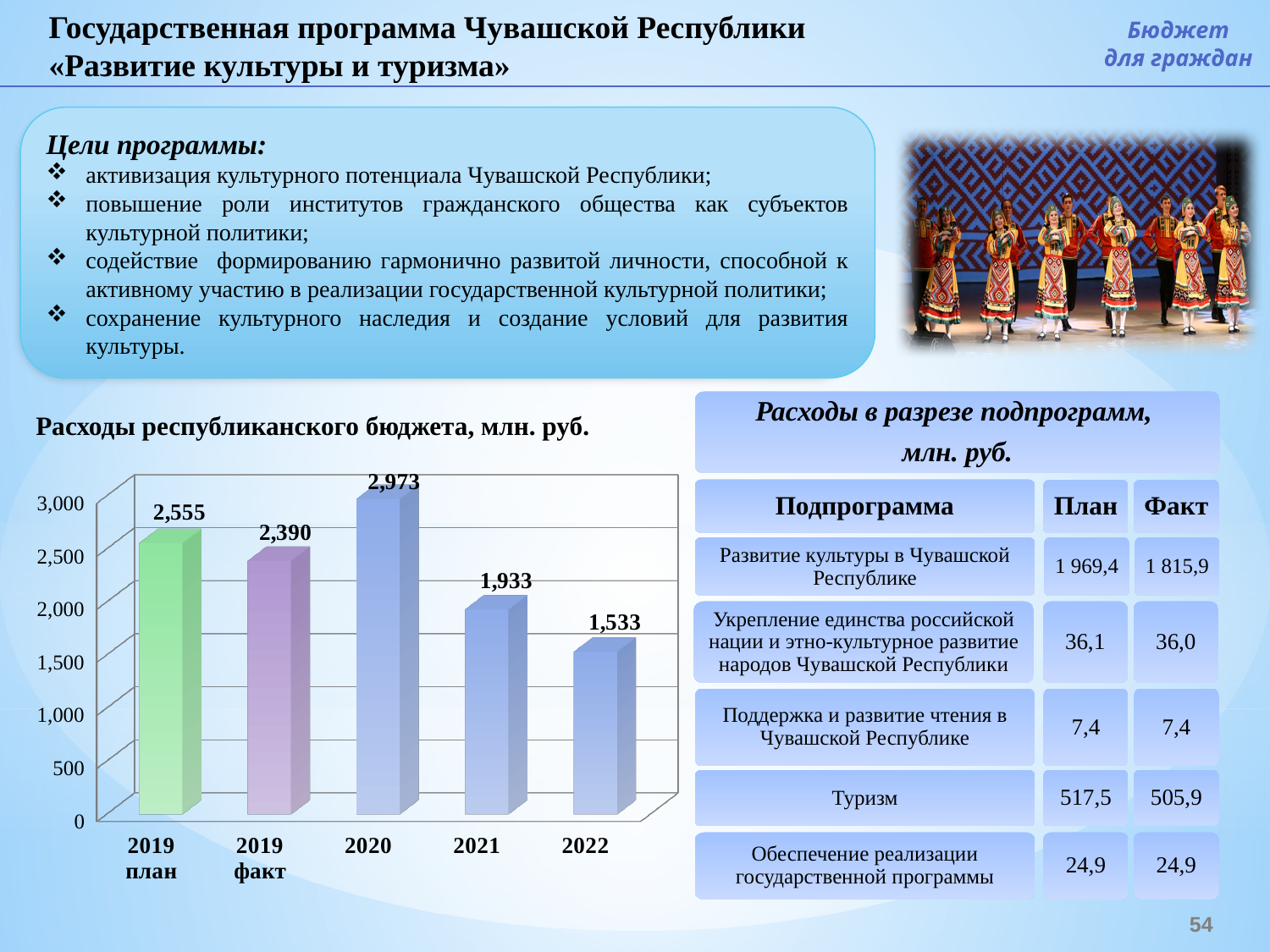
What is the difference between the 2020 and 2021 values in the chart 'Расходы республиканского бюджета, млн. руб.'? 1,040 Which is larger in the chart 'Расходы республиканского бюджета, млн. руб.': the value for 2021 or the value for 2022? 2021 What type of chart is 'Расходы республиканского бюджета, млн. руб.'? bar chart Is the value for 2021 in the chart 'Расходы республиканского бюджета, млн. руб.' greater or less than 2,000? less What is the value for 2019 план in the chart 'Расходы республиканского бюджета, млн. руб.'? 2,555 What is the value for 2020 in the chart 'Расходы республиканского бюджета, млн. руб.'? 2,973 How many bars are shown in the chart 'Расходы республиканского бюджета, млн. руб.'? 5 What is the value for 2022 in the chart 'Расходы республиканского бюджета, млн. руб.'? 1,533 Do the values rise or fall from 2020 to 2022 in the chart 'Расходы республиканского бюджета, млн. руб.'? fall Which category has the highest value in the chart 'Расходы республиканского бюджета, млн. руб.'? 2020 Which category has the lowest value in the chart 'Расходы республиканского бюджета, млн. руб.'? 2022 What is the difference between the 2019 план and 2019 факт values in the chart 'Расходы республиканского бюджета, млн. руб.'? 165